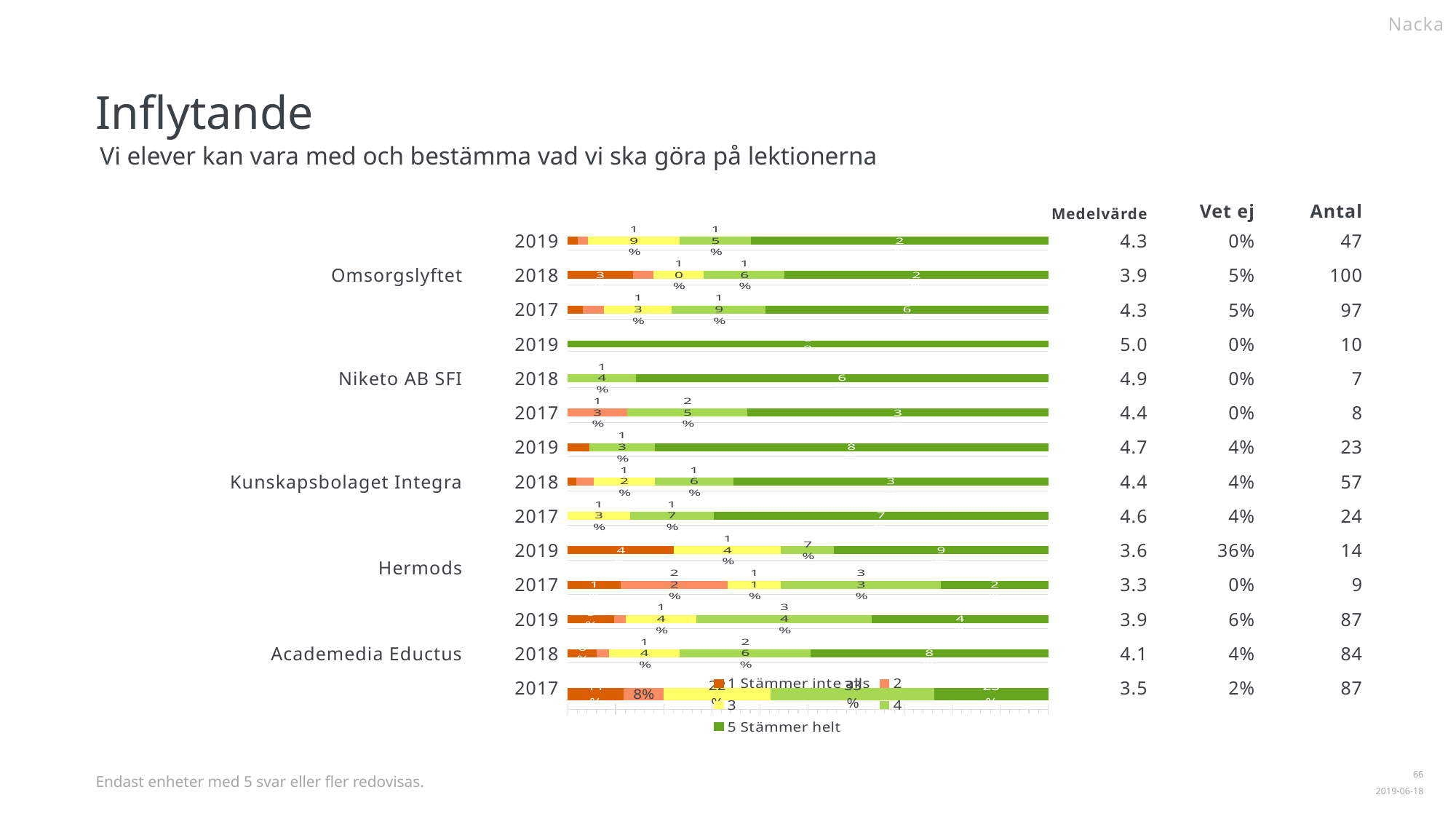
What is the first entry in the chart legend? 1 Stämmer inte alls Which bar has the largest '5 Stämmer helt' segment? Niketo AB SFI 2019 What is the Antal shown for Omsorgslyftet 2018? 100 What is the Vet ej value shown for Hermods 2019? 36% How many series does the chart legend list? 5 What is the Medelvärde shown for Hermods 2019? 3.6 What kind of chart is shown on the slide? Stacked bar chart For Hermods, which year has the larger '5 Stämmer helt' segment, 2019 or 2017? 2019 How many providers (units) are listed along the chart's category axis? 5 What is the last entry in the chart legend? 5 Stämmer helt How many bars (year rows) are plotted in the chart? 14 Which row has the lowest Medelvärde? Hermods 2017